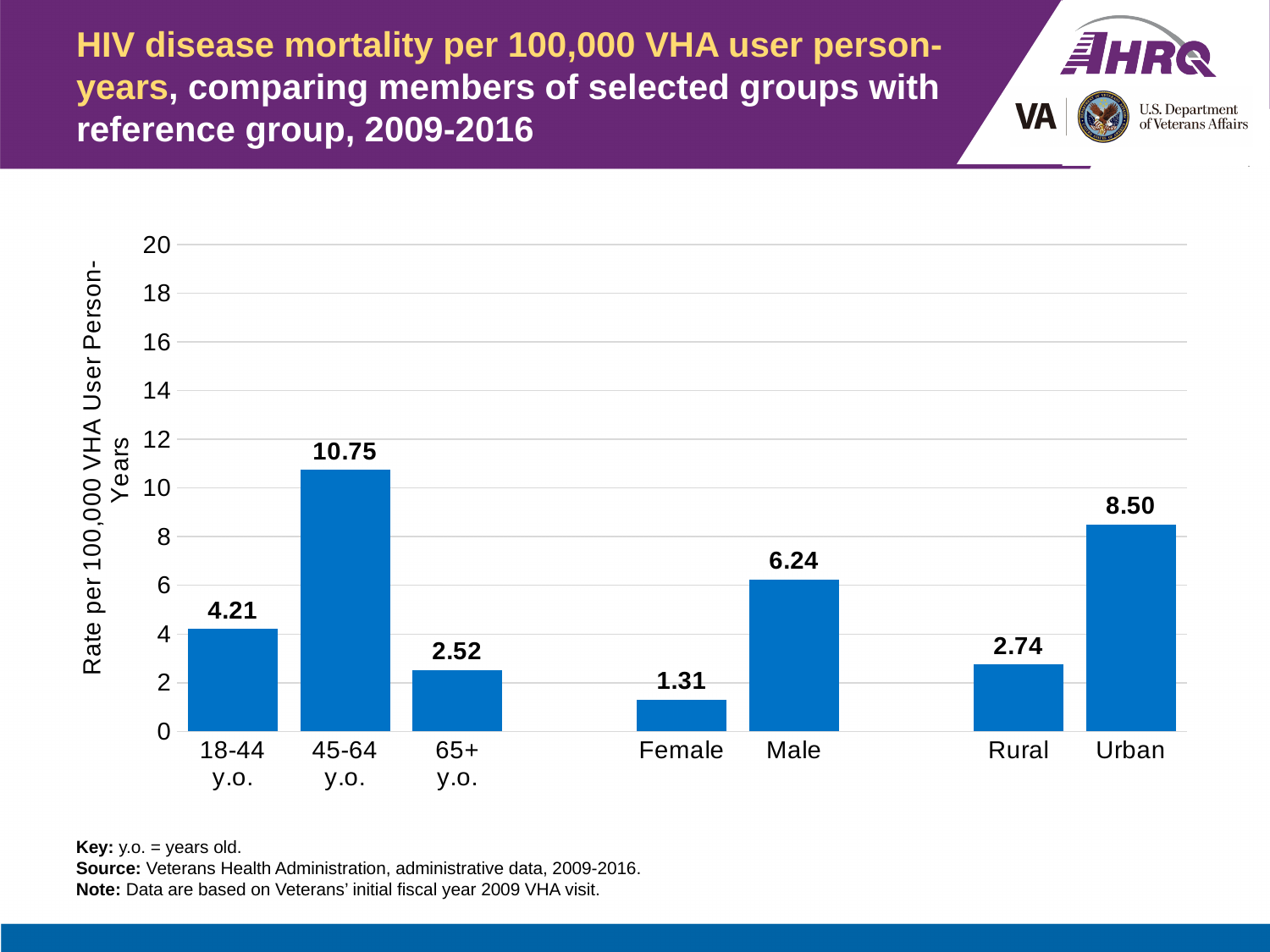
What is the rate for Urban veterans? 8.50 Which has a higher rate, the 18-44 y.o. group or the 65+ y.o. group? 18-44 y.o. What is the rate for Female veterans? 1.31 What kind of chart is shown on the slide? Bar chart What is the difference between the Male and Female rates? 4.93 Which group has the highest HIV disease mortality rate? 45-64 y.o. Is the value for Rural greater or less than 4? less Which group has the lowest HIV disease mortality rate? Female What is the difference between the Urban and Rural rates? 5.76 What is the HIV disease mortality rate for the 45-64 y.o. group? 10.75 What is the rate for the 65+ y.o. group? 2.52 How many groups are shown on the chart? 7